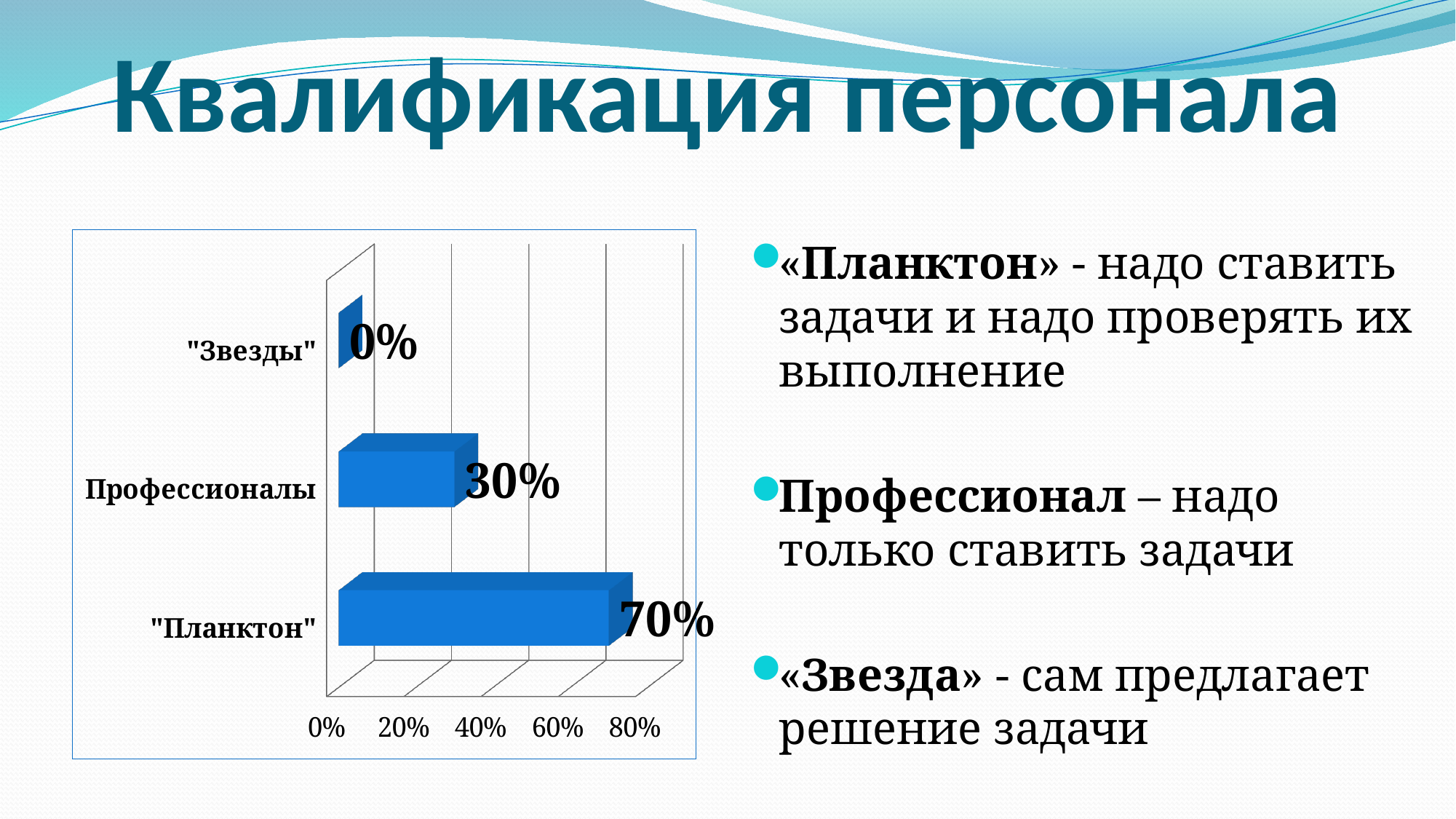
What is the highest tick value shown on the chart's value axis? 80% How many categories are shown in the chart? 3 Is the value for "Профессионалы" greater or less than 40%? less Is the value for "Планктон" greater or less than 60%? greater Which is larger, the value for "Профессионалы" or the value for "Звезды"? "Профессионалы" What is the value for "Звезды"? 0% What is the difference between the values for "Планктон" and "Профессионалы"? 40% Which category has the lowest value? "Звезды" What kind of chart is shown on the slide? bar chart Which category has the highest value? "Планктон" What is the value for "Профессионалы"? 30% What is the value for "Планктон"? 70%